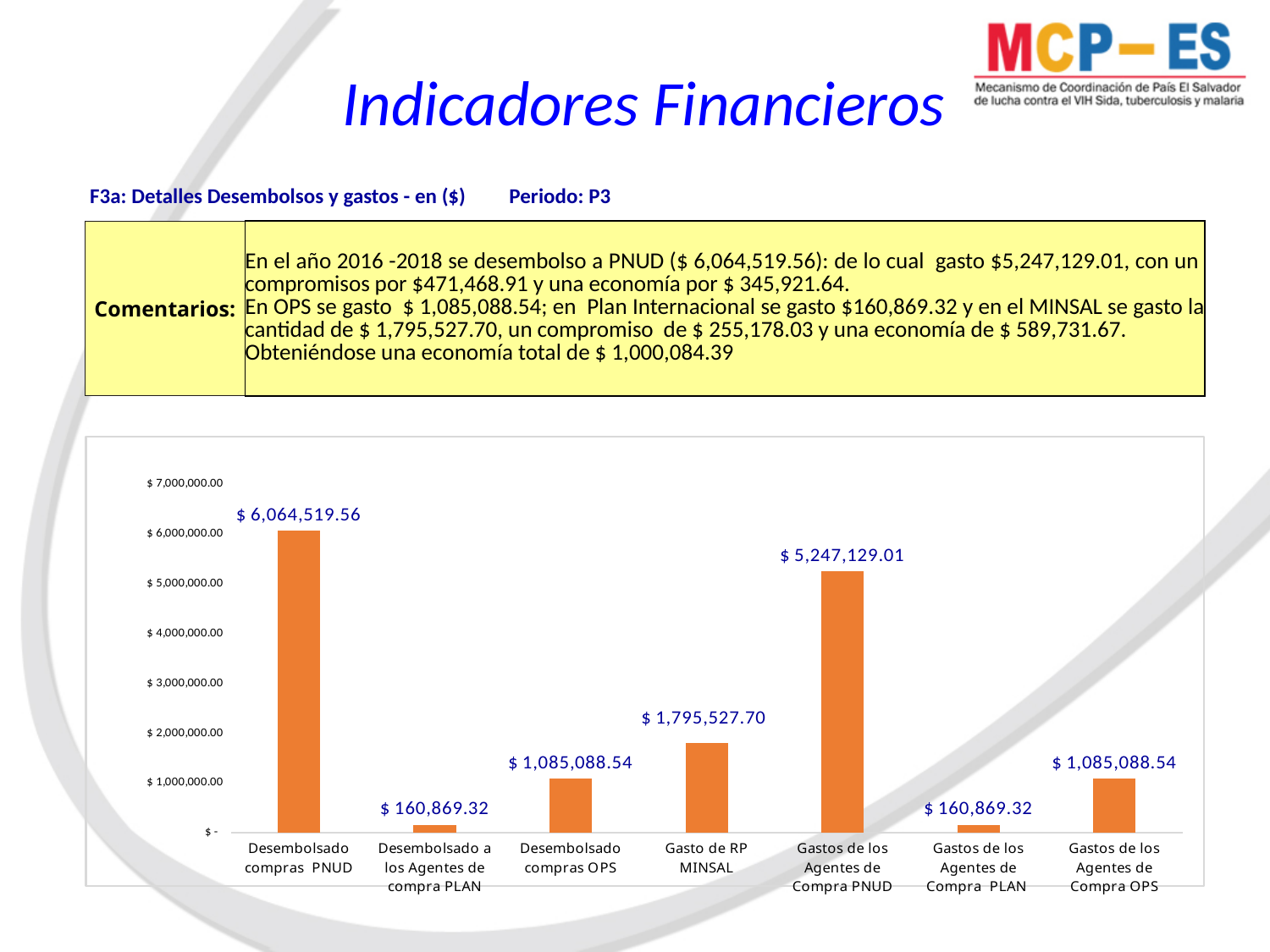
What is the value for Desembolsado compras PNUD? $ 6,064,519.56 Which category has the highest value? Desembolsado compras PNUD How many categories are shown in the chart? 7 What is the value for Desembolsado a los Agentes de compra PLAN? $ 160,869.32 What is the value for Gastos de los Agentes de Compra PNUD? $ 5,247,129.01 What is the lowest value shown in the chart? $ 160,869.32 What kind of chart is shown on the slide? Bar chart What is the difference between Desembolsado compras PNUD and Gastos de los Agentes de Compra PNUD? $ 817,390.55 What is the value for Gasto de RP MINSAL? $ 1,795,527.70 What is the value for Desembolsado compras OPS? $ 1,085,088.54 What is the difference between Gasto de RP MINSAL and Desembolsado compras OPS? $ 710,439.16 Which is larger, Gasto de RP MINSAL or Gastos de los Agentes de Compra OPS? Gasto de RP MINSAL